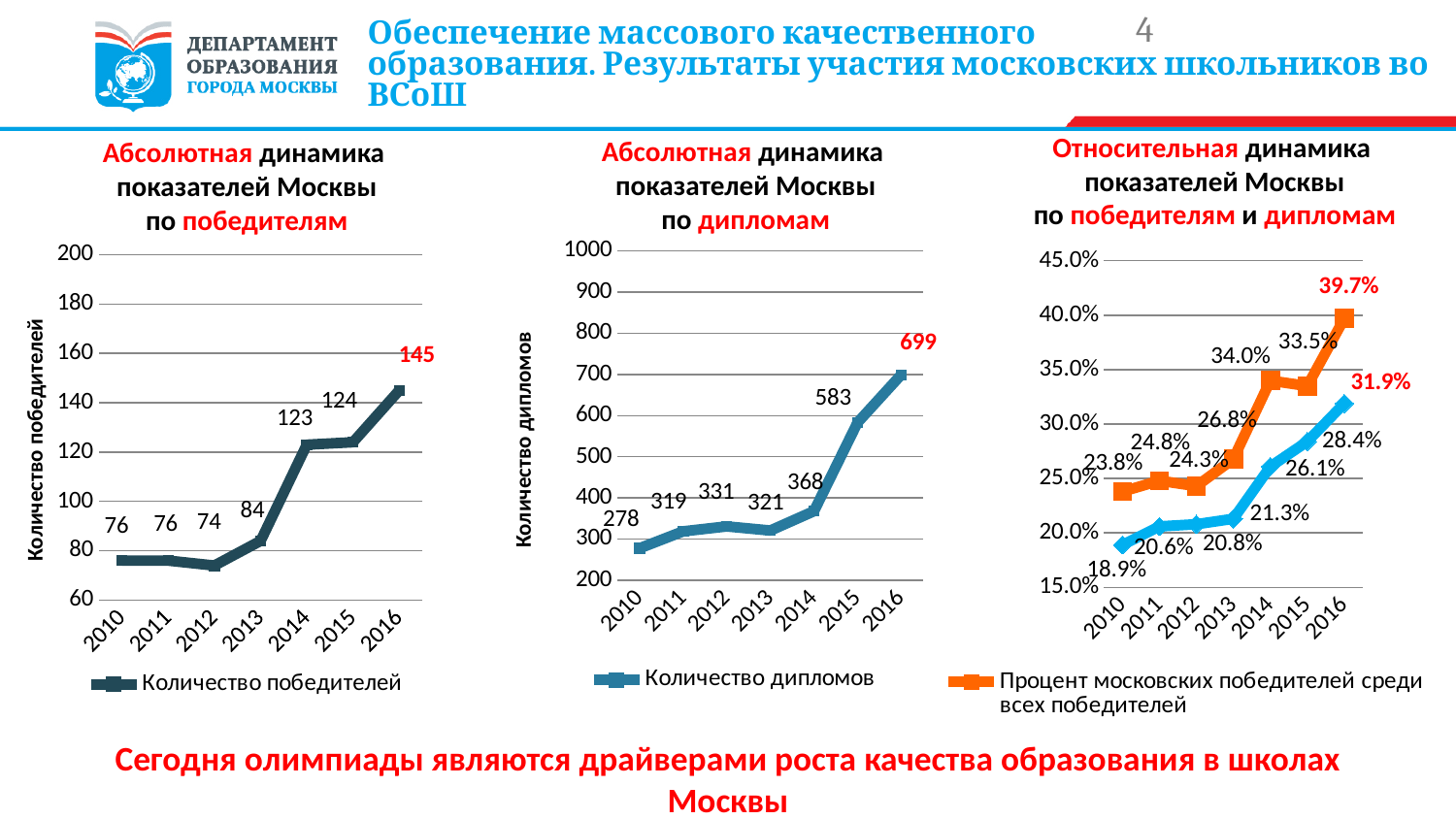
On the right chart (Относительная динамика), does the orange series generally rise or fall from 2010 to 2016? rise On the left chart (по победителям), how many years are plotted on the x axis? 7 On the right chart (Относительная динамика), what is the value of the series 'Процент московских победителей среди всех победителей' for 2016? 39.7% On the middle chart (Абсолютная динамика показателей Москвы по дипломам), what is the value for 2015? 583 On the middle chart (по дипломам), which year has the highest number of diplomas? 2016 On the right chart (Относительная динамика), what is the value of the blue line for 2010? 18.9% On the left chart (Абсолютная динамика показателей Москвы по победителям), what is the value for 2016? 145 What type of chart is the middle chart (по дипломам)? line chart On the middle chart (по дипломам), is the value for 2012 larger or smaller than the value for 2013? larger On the left chart (по победителям), what is the difference between the values for 2014 and 2013? 39 On the middle chart (по дипломам), what is the difference between the values for 2016 and 2010? 421 On the left chart (по победителям), which year has the lowest number of winners? 2012